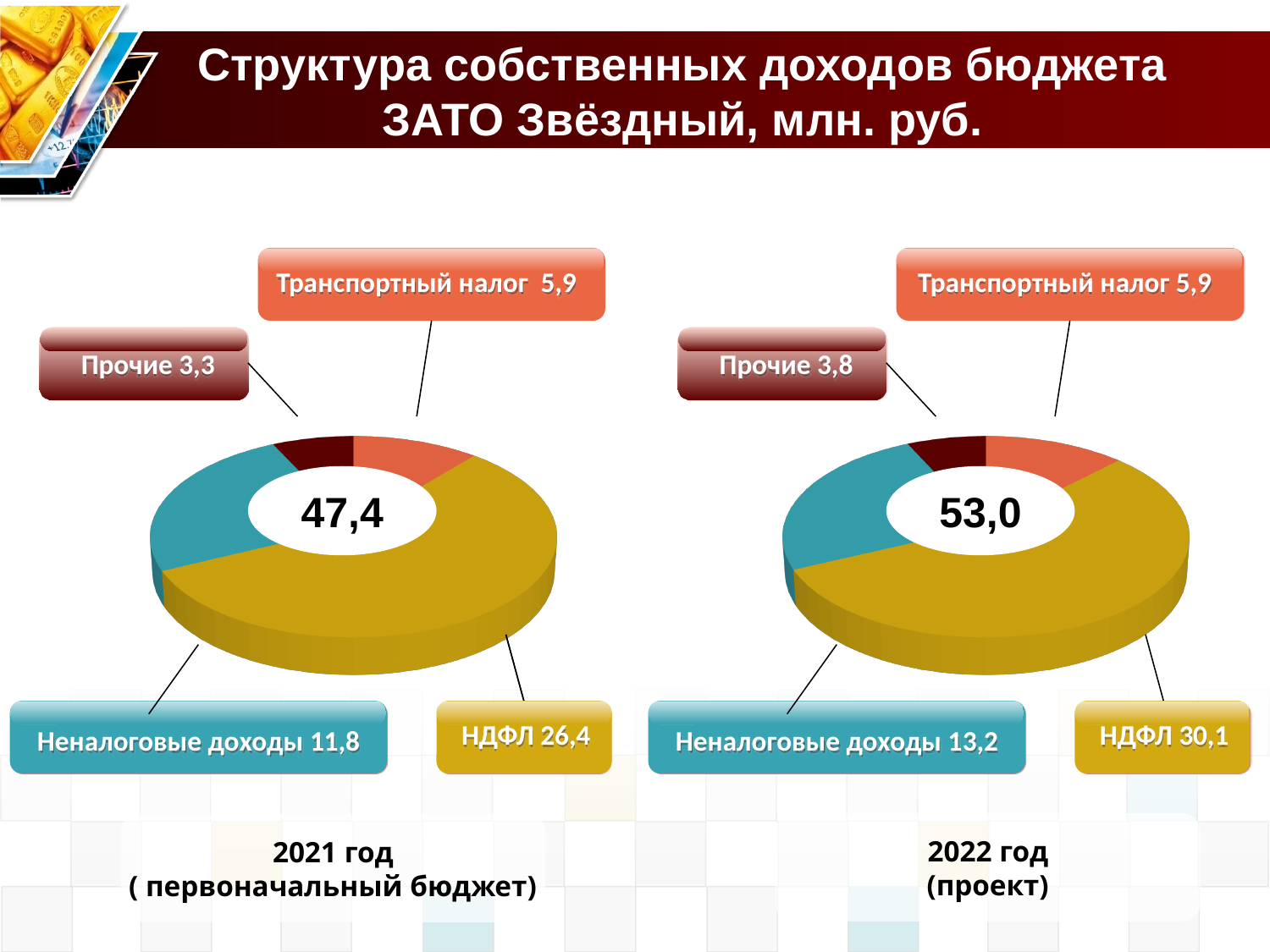
On the 2021 chart (left), what is the difference between Неналоговые доходы and Транспортный налог? 5,9 On the 2021 chart (left), which category has the largest value? НДФЛ How many categories does the 2021 chart (left) show? 4 What is the difference between НДФЛ in the 2022 chart and НДФЛ in the 2021 chart? 3,7 What is the title of the slide? Структура собственных доходов бюджета ЗАТО Звёздный, млн. руб. On the 2022 chart (right), which category has the smallest value? Прочие What is the total shown in the centre of the 2022 chart (right)? 53,0 On the 2021 chart (left), what is the value for НДФЛ? 26,4 What kind of chart is used on this slide? doughnut chart On the 2022 chart (right), what is the value for Прочие? 3,8 On the 2022 chart (right), what is the value for Неналоговые доходы? 13,2 Which is larger: Прочие in the 2021 chart or Прочие in the 2022 chart? 2022 chart (3,8)